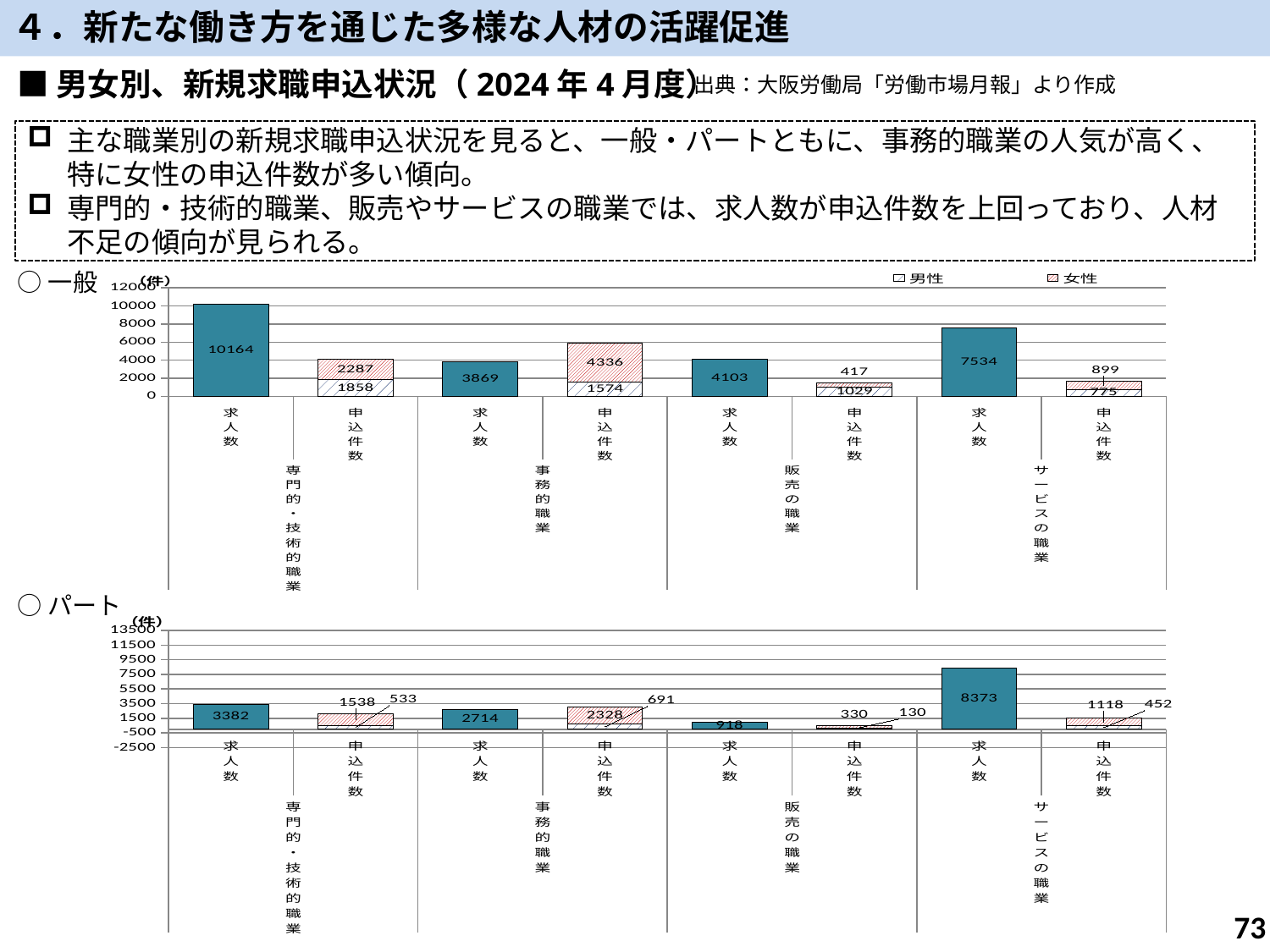
In the top chart (一般), what is the difference between the 求人数 for サービスの職業 and the 求人数 for 事務的職業? 3665 In the top chart (一般), what is the total 申込件数 (男性 plus 女性) for サービスの職業? 1674 In the bottom chart (パート), which occupation has the lowest 求人数? 販売の職業 In the bottom chart (パート), which is larger: the 求人数 for 専門的・技術的職業 or the 求人数 for 事務的職業? 専門的・技術的職業 What kind of chart is the bottom chart (パート)? bar chart In the top chart (一般), what is the 女性 申込件数 value for 事務的職業? 4336 In the bottom chart (パート), what is the 求人数 value for サービスの職業? 8373 In the top chart (一般), which occupation has the highest 求人数? 専門的・技術的職業 In the top chart (一般), what is the 求人数 value for 専門的・技術的職業? 10164 How many series does the legend of the top chart (一般) list? 2 In the bottom chart (パート), what is the 男性 申込件数 value for 事務的職業? 691 In the top chart (一般), what is the 男性 申込件数 value for 販売の職業? 1029